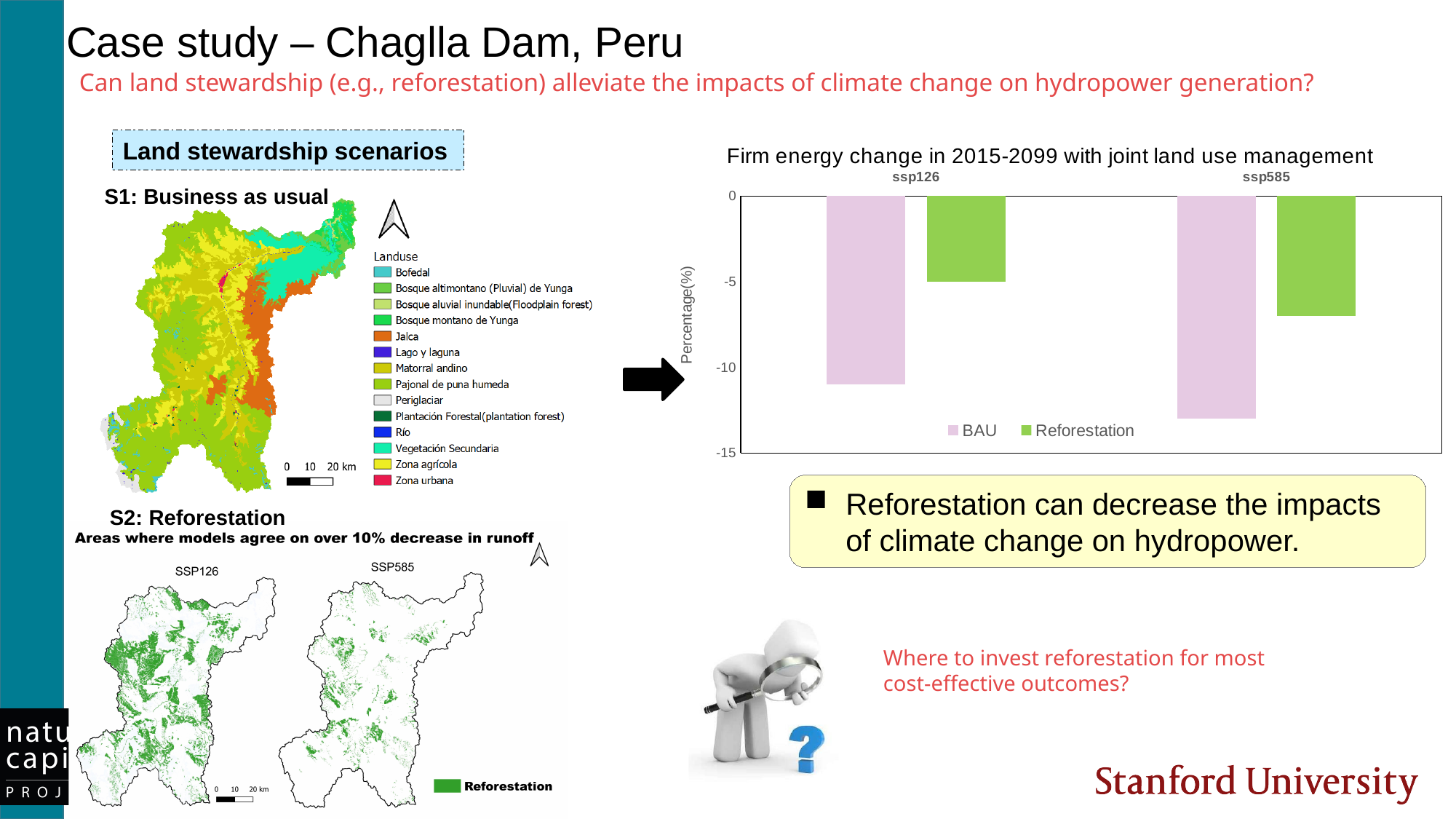
What kind of chart is used to show firm energy change in 2015-2099 with joint land use management? bar chart In the firm energy change chart, under ssp126, which is larger (less negative): the BAU value or the Reforestation value? Reforestation How many scenario groups (categories) are shown on the x axis of the firm energy change chart? 2 In the firm energy change chart, is the BAU value for ssp585 greater or less than -10? less How many series does the legend of the firm energy change chart list? 2 In the firm energy change chart, which series is shown in green? Reforestation In the firm energy change chart, is the Reforestation value for ssp585 greater or less than -5? less In the firm energy change chart, which bar shows the largest decrease (lowest value)? BAU under ssp585 In the firm energy change chart, is the BAU value for ssp126 greater or less than -10? less What is the y-axis label of the firm energy change chart? Percentage(%) In the firm energy change chart, which bar shows the smallest decrease (highest value)? Reforestation under ssp126